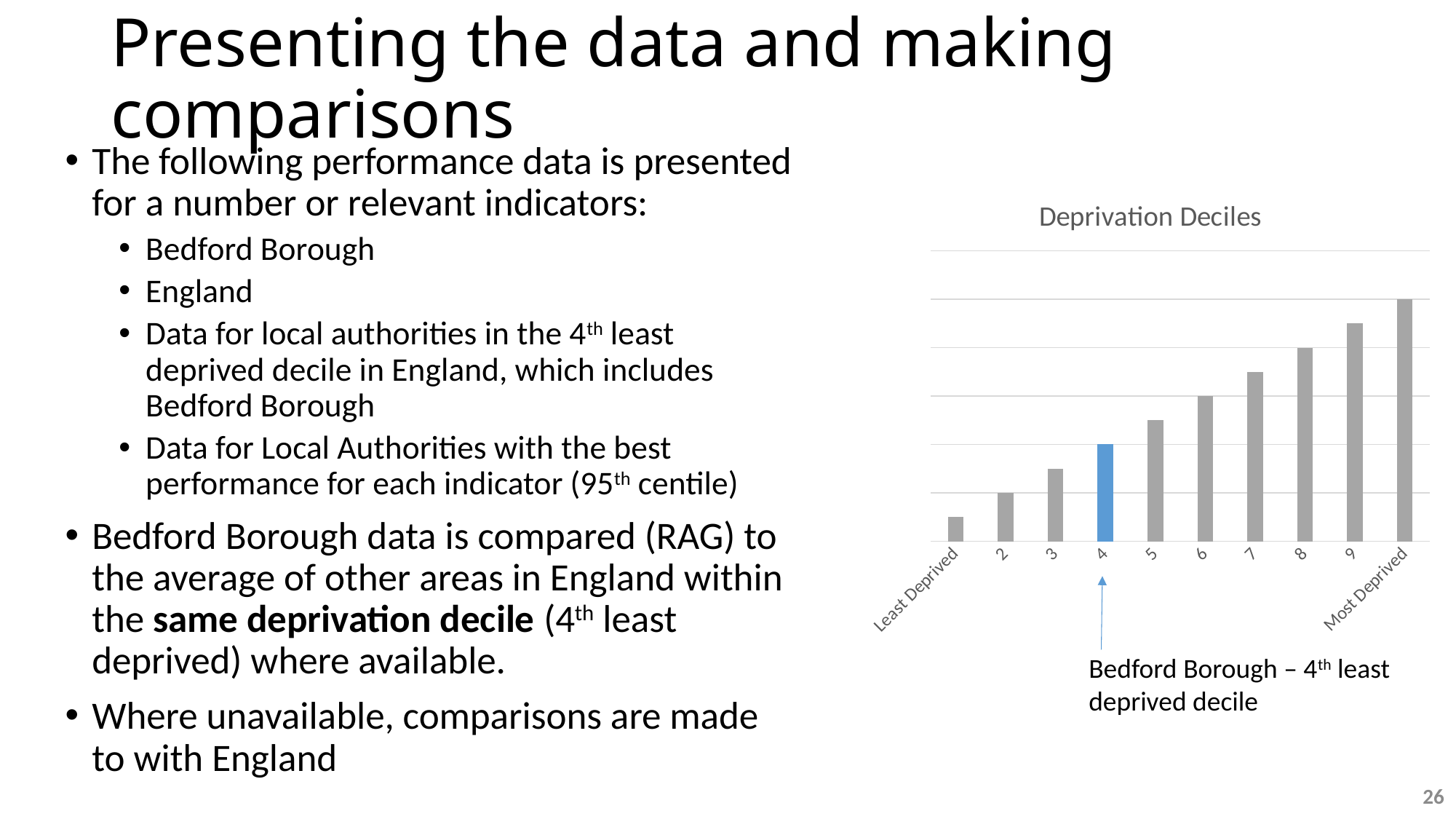
Which category has the tallest bar in the Deprivation Deciles chart? Most Deprived What is the label of the first category on the x axis of the Deprivation Deciles chart? Least Deprived Which bar is taller in the Deprivation Deciles chart, decile 4 or decile 7? Decile 7 Which decile's bar is highlighted in blue in the Deprivation Deciles chart? 4 How many bars are plotted in the Deprivation Deciles chart? 10 Which bar is taller in the Deprivation Deciles chart, decile 2 or decile 5? Decile 5 Which category has the shortest bar in the Deprivation Deciles chart? Least Deprived What is the title of the chart? Deprivation Deciles What is the label of the last category on the x axis of the Deprivation Deciles chart? Most Deprived Do the bar heights rise or fall moving from Least Deprived to Most Deprived along the x axis? Rise What type of chart is shown on the slide? Bar chart